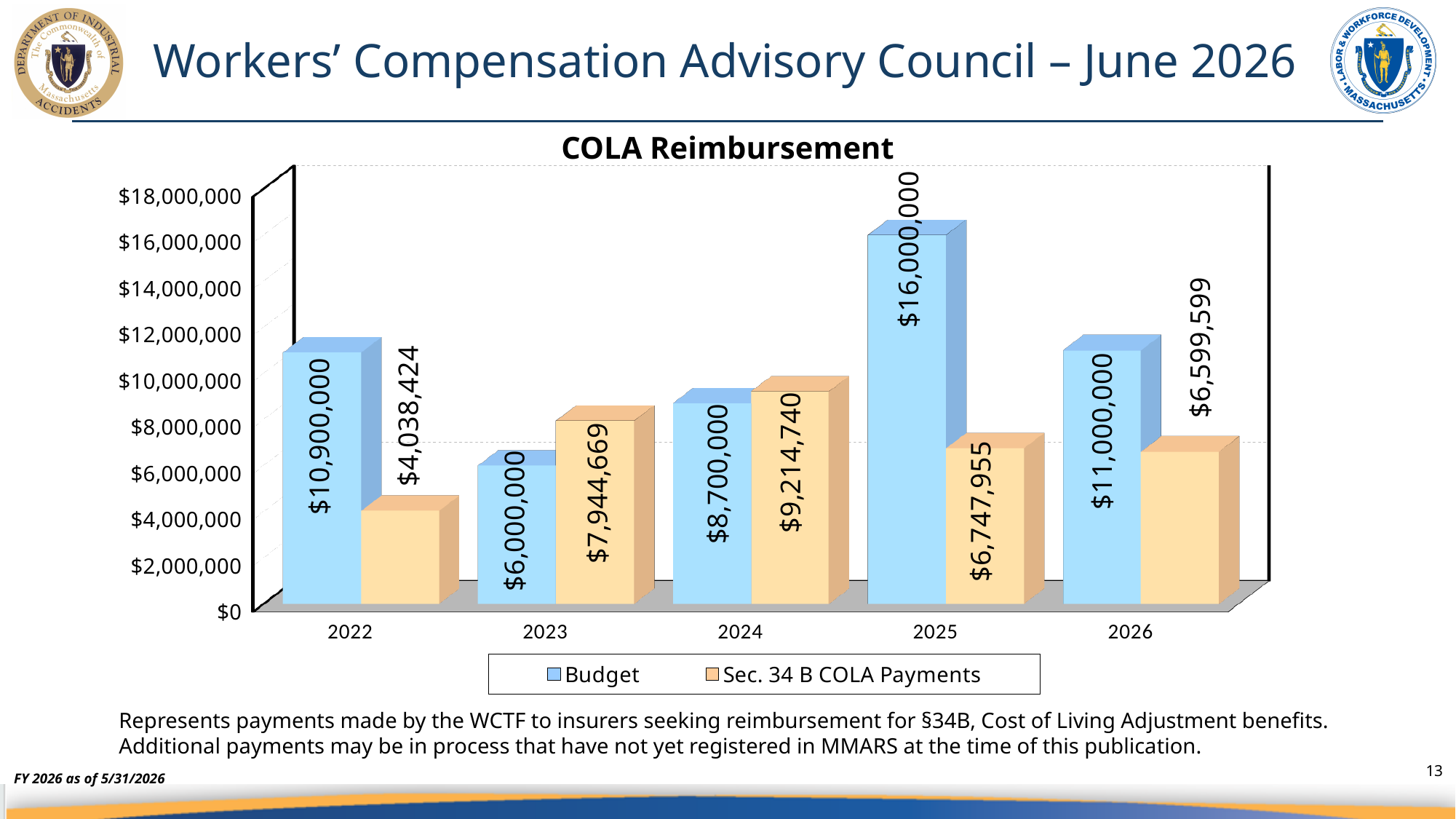
Which year has the highest Budget value? 2025 What kind of chart is the COLA Reimbursement chart? Bar chart Which year has the lowest Sec. 34 B COLA Payments value? 2022 What is the Budget value for 2025 in the COLA Reimbursement chart? $16,000,000 What is the Sec. 34 B COLA Payments value for 2023? $7,944,669 How many years are shown on the x axis of the COLA Reimbursement chart? 5 In 2024, which is larger: the Budget or the Sec. 34 B COLA Payments? Sec. 34 B COLA Payments What is the difference between the Budget and the Sec. 34 B COLA Payments in 2022? $6,861,576 What is the Sec. 34 B COLA Payments value for 2026? $6,599,599 Which year has the lowest Budget value? 2023 Is the Budget value for 2026 greater or less than $10,000,000? greater How many series does the legend list? 2